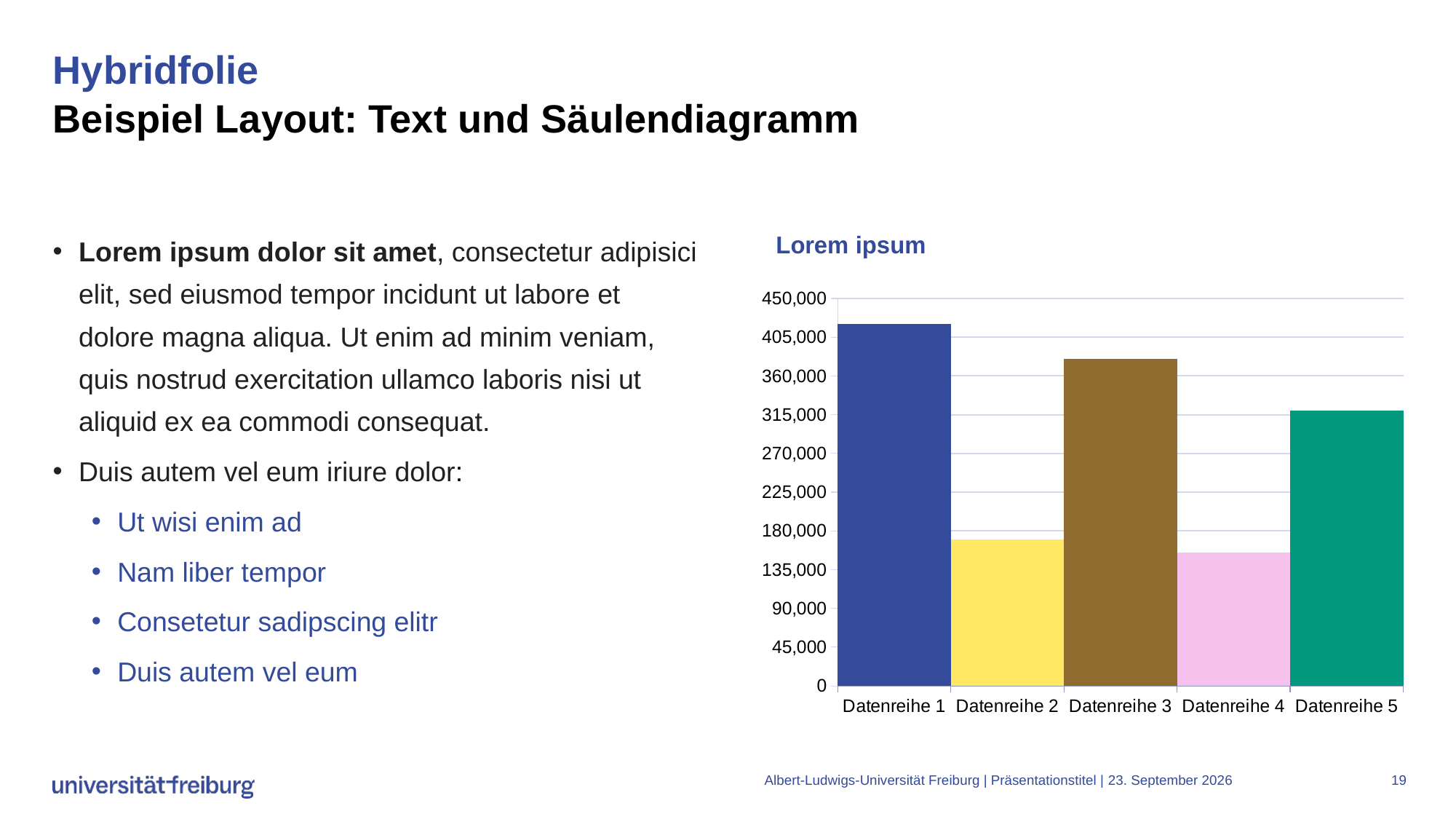
Is the value for Datenreihe 2 greater or less than 180,000? less How many categories are shown on the x axis of the chart? 5 Which category has the highest bar in the chart? Datenreihe 1 Which is larger, the value for Datenreihe 1 or the value for Datenreihe 3? Datenreihe 1 What is the title of the chart? Lorem ipsum Which category has the lowest bar in the chart? Datenreihe 4 Which is larger, the value for Datenreihe 2 or the value for Datenreihe 5? Datenreihe 5 Is the value for Datenreihe 1 greater or less than 405,000? greater Is the value for Datenreihe 5 greater or less than 360,000? less What kind of chart is shown on the slide? bar chart